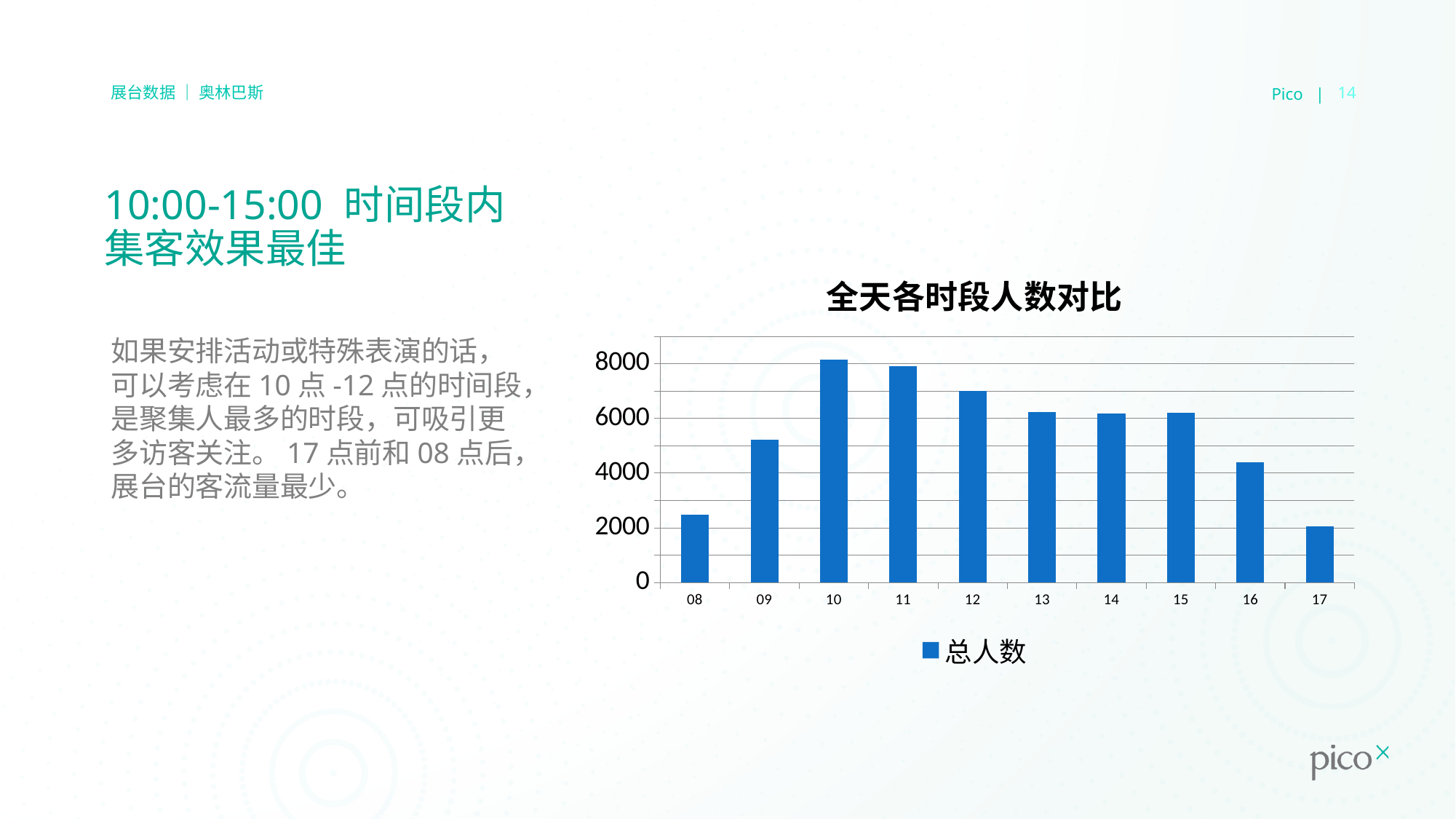
Do the values rise or fall from 10 to 17 along the x axis? fall What type of chart is shown on the slide? Bar chart Which time slot has the lowest value? 17 What is the title of the chart? 全天各时段人数对比 Is the value for 09 greater or less than 6000? less Which time slot has the highest value? 10 Which is larger, the value for 09 or the value for 16? 09 How many time-slot categories are plotted on the x axis? 10 Is the value for 08 greater or less than 2000? greater What series name does the chart legend list? 总人数 How many series does the legend list? 1 Is the value for 16 greater or less than 4000? greater